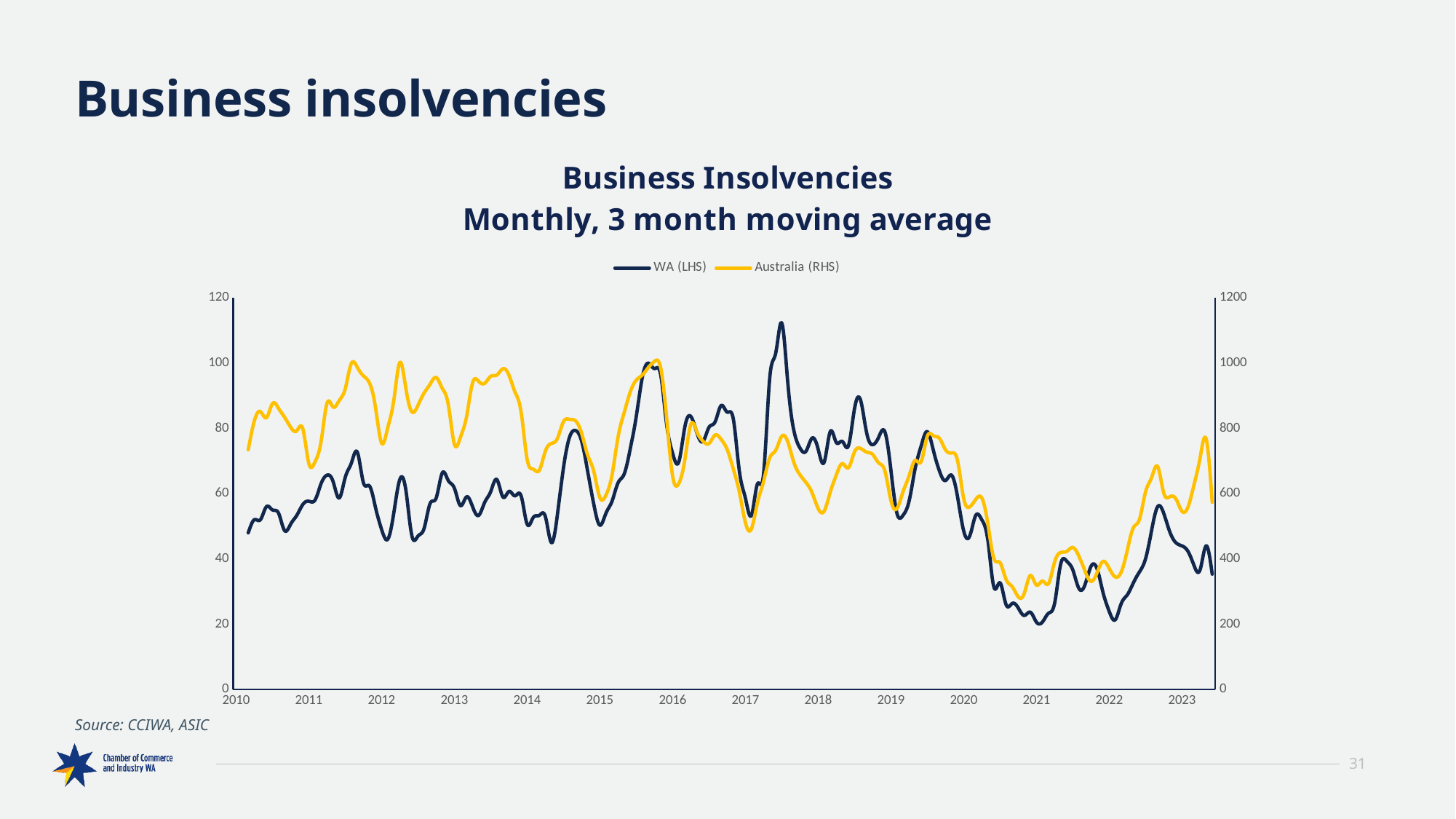
Does the Australia (RHS) series rise or fall between 2021 and 2023? Rise Is the value of the Australia (RHS) series at the start of 2021 greater or less than 600? less How many series does the legend list? 2 Which series is plotted against the right-hand axis? Australia (RHS) Is the value of the Australia (RHS) series at the start of 2010 greater or less than 600? greater What is the title of the chart? Business Insolvencies Monthly, 3 month moving average Is the value of the WA (LHS) series at the start of 2021 greater or less than 40? less Does the WA (LHS) series rise or fall between 2019 and 2021? Fall In which year does the WA (LHS) series reach its lowest value? 2021 In which year does the WA (LHS) series reach its highest value? 2017 What kind of chart is shown on the slide? Line chart